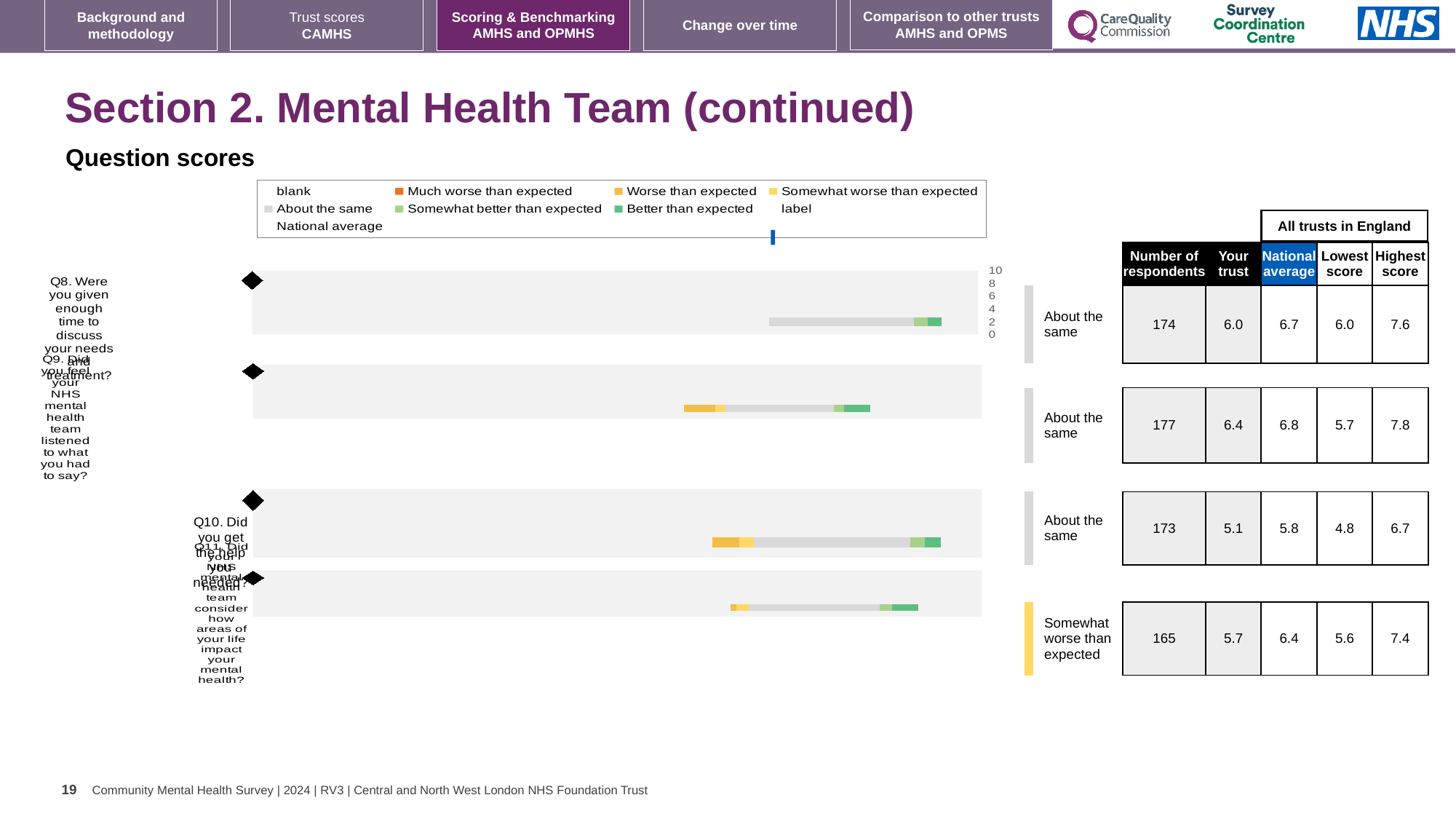
In the table beside the chart, which question has the highest 'Your trust' score? Q9 What kind of chart is used to show the question scores on this slide? bar chart Which legend entry in the question scores chart is shown in orange? Much worse than expected In the table beside the chart, what is the difference between the national average and the 'Your trust' score for Q8? 0.7 What is the highest value shown on the score axis of the question scores chart? 10 In the table beside the chart, which question has the lowest number of respondents? Q11 In the table beside the chart, what is the highest score for Q11? 7.4 In the table beside the chart, what is the national average for Q10? 5.8 How many survey questions (categories) are plotted in the question scores chart? 4 In the table beside the chart, which is larger for Q9: the 'Your trust' score or the national average? National average In the table beside the chart, how many respondents are listed for Q8? 174 In the table beside the chart, what is the 'Your trust' score for Q9? 6.4